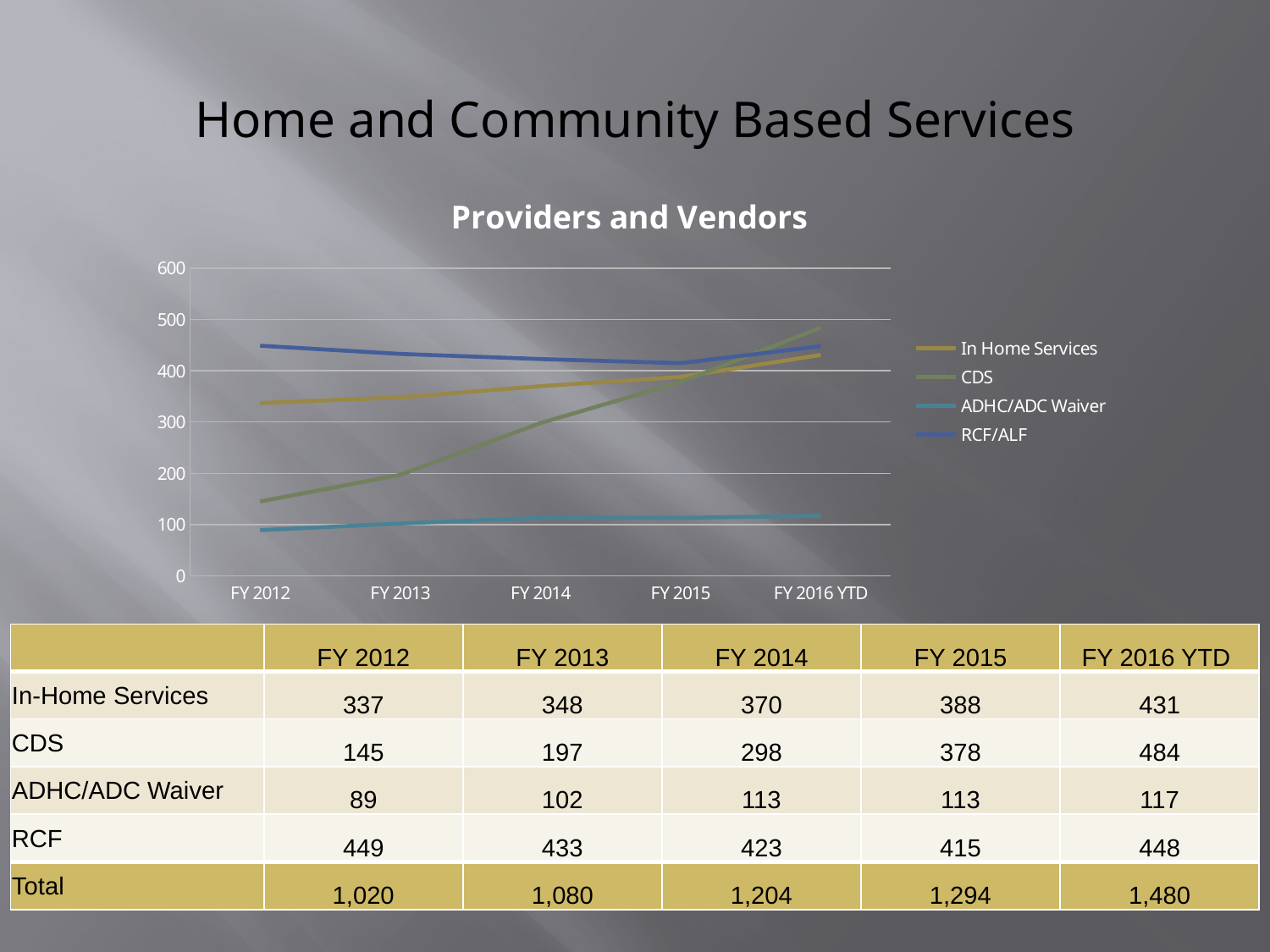
How many fiscal year points are plotted along the x axis of the 'Providers and Vendors' chart? 5 What is the total of all four series in FY 2015? 1,294 What is the value for CDS in FY 2016 YTD? 484 In FY 2014, which is larger: In-Home Services or CDS? In-Home Services Which series has the highest value in FY 2016 YTD? CDS Does the CDS line rise or fall from FY 2012 to FY 2016 YTD? rise How many series does the legend of the 'Providers and Vendors' chart list? 4 Is the value for RCF/ALF in FY 2015 greater or less than 400? greater Which series has the lowest value in FY 2012? ADHC/ADC Waiver What is the value for In-Home Services in FY 2012? 337 What is the difference between the CDS values in FY 2016 YTD and FY 2012? 339 What type of chart is shown under the title 'Providers and Vendors'? line chart